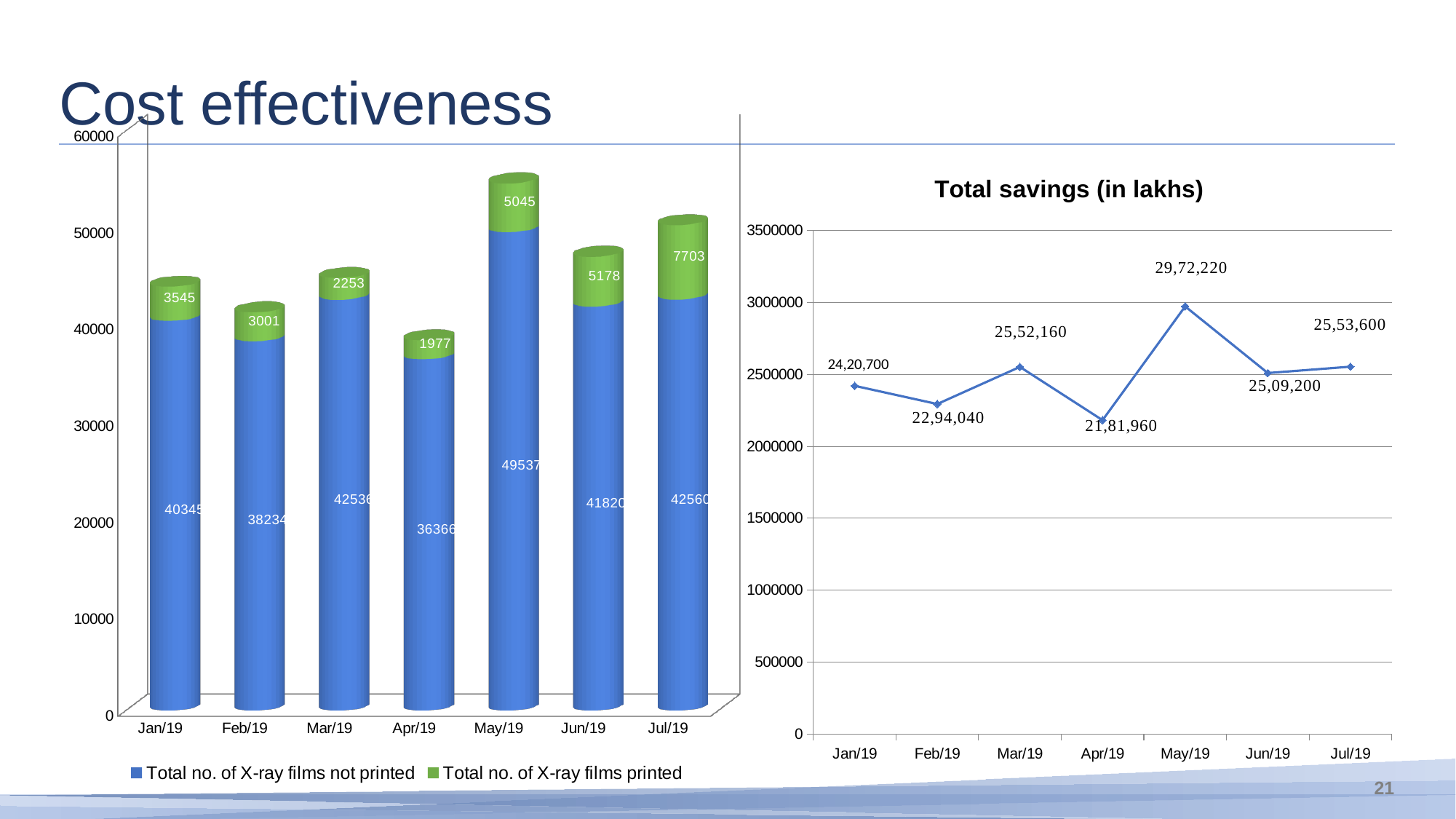
In the left bar chart, which month has the lowest value for Total no. of X-ray films printed? Apr/19 In the left bar chart, which month has the highest value for Total no. of X-ray films not printed? May/19 In the 'Total savings (in lakhs)' chart, how many data points are plotted? 7 In the 'Total savings (in lakhs)' chart, which month has the lowest value? Apr/19 In the 'Total savings (in lakhs)' chart, what is the value for May/19? 29,72,220 What kind of chart is the chart on the left of the slide? Stacked bar chart In the left bar chart, what is the value for Total no. of X-ray films not printed in May/19? 49537 In the left bar chart, what is the total of the stacked bar for Jan/19? 43890 In the 'Total savings (in lakhs)' chart, is the value for Mar/19 or Jun/19 larger? Mar/19 In the left bar chart, how many series does the legend list? 2 In the left bar chart, what is the value for Total no. of X-ray films printed in Jul/19? 7703 In the left bar chart, what is the difference between Total no. of X-ray films printed in Jul/19 and in Jun/19? 2525